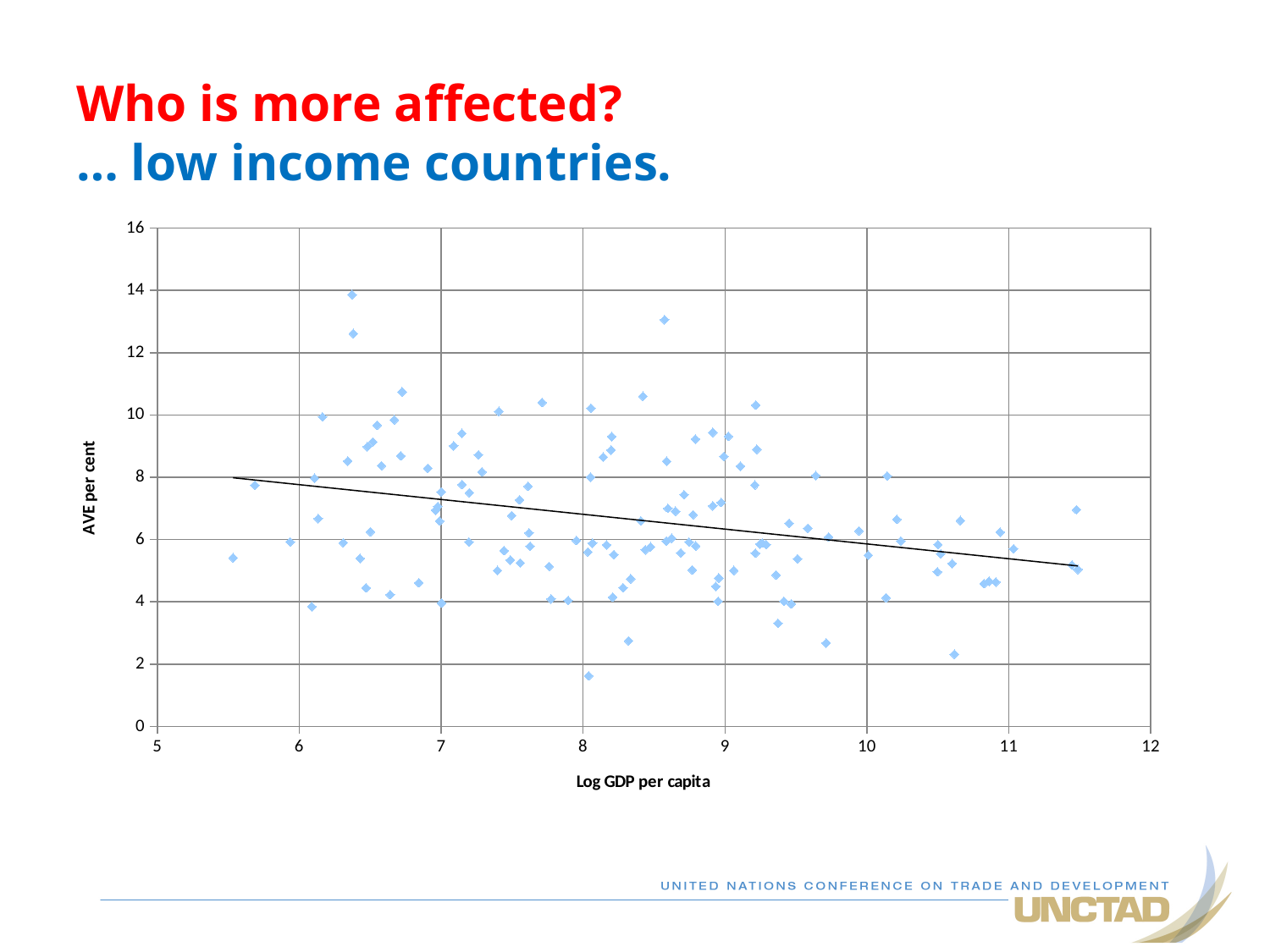
Is the lowest AVE per cent value plotted greater or less than 2? less As Log GDP per capita increases along the x axis, does the fitted trend line rise or fall? Fall Is the highest AVE per cent value plotted greater or less than 12? greater Is the Log GDP per capita of the point with the highest AVE per cent greater or less than 7? less Is the AVE per cent value of the trend line higher at Log GDP per capita 6 or at Log GDP per capita 11? At 6 What is the title of the x axis of the chart? Log GDP per capita What is the title of the y axis of the chart? AVE per cent What kind of chart is shown on the slide? Scatter plot